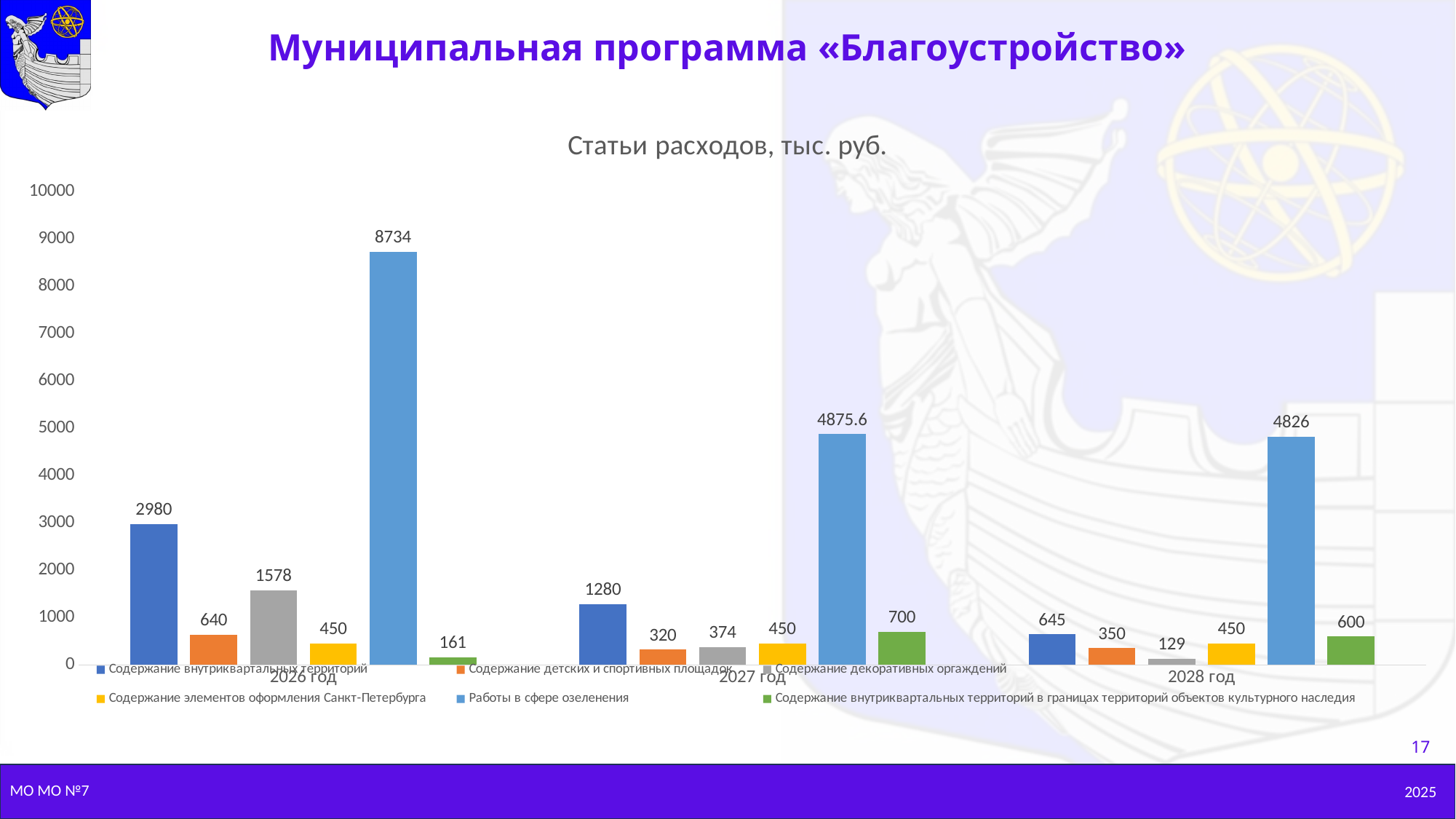
Which year has the highest value for Работы в сфере озеленения? 2026 год Which series has the lowest value in 2026 год? Содержание внутриквартальных территорий в границах территорий объектов культурного наследия Which is larger: Содержание детских и спортивных площадок in 2027 год or in 2028 год? 2028 год What is the difference between Содержание внутриквартальных территорий in 2026 год and in 2028 год? 2335 How many series does the legend list? 6 What is the value for Работы в сфере озеленения in 2027 год? 4875.6 What is the title of the chart? Статьи расходов, тыс. руб. What is the value for Содержание внутриквартальных территорий in 2027 год? 1280 What is the value for Содержание декоративных оргаждений in 2028 год? 129 What kind of chart is shown on the slide? Bar chart What is the value for Работы в сфере озеленения in 2026 год? 8734 How many year categories are shown on the x axis? 3